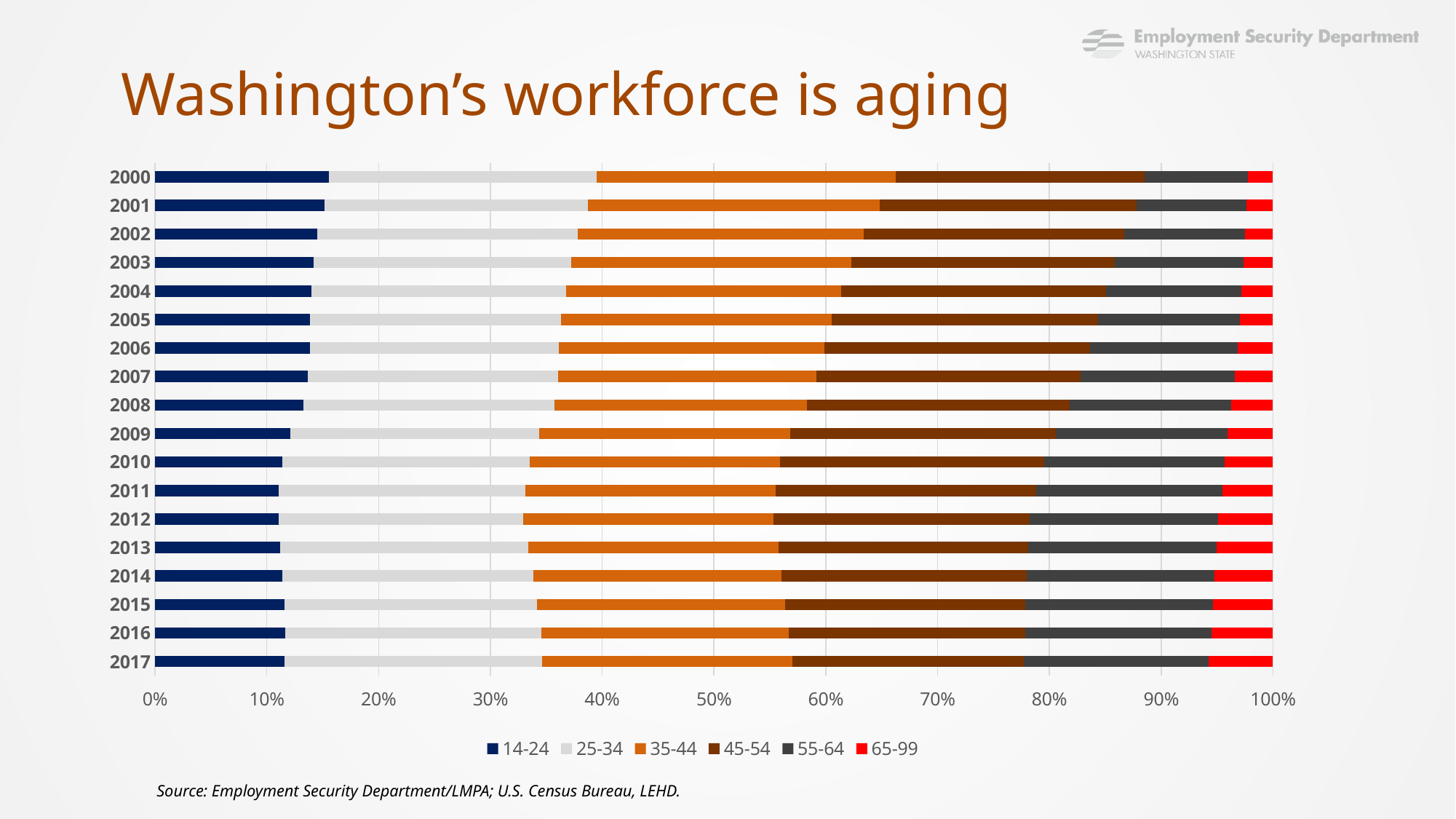
What kind of chart is shown on the slide? Stacked bar chart Is the 14-24 share in 2000 greater or less than 10%? greater How many age groups does the legend list? 6 How many years are shown on the chart? 18 What does each stacked bar total? 100% What is the title of the slide? Washington's workforce is aging Is the 65-99 share in 2017 greater or less than 10%? less Which age group is shown in red in the legend? 65-99 Does the share of the 65-99 age group rise or fall from 2000 to 2017? Rise Which year has the largest 14-24 segment? 2000 Which year has the larger 55-64 segment, 2000 or 2017? 2017 Does the share of the 14-24 age group rise or fall from 2000 to 2017? Fall